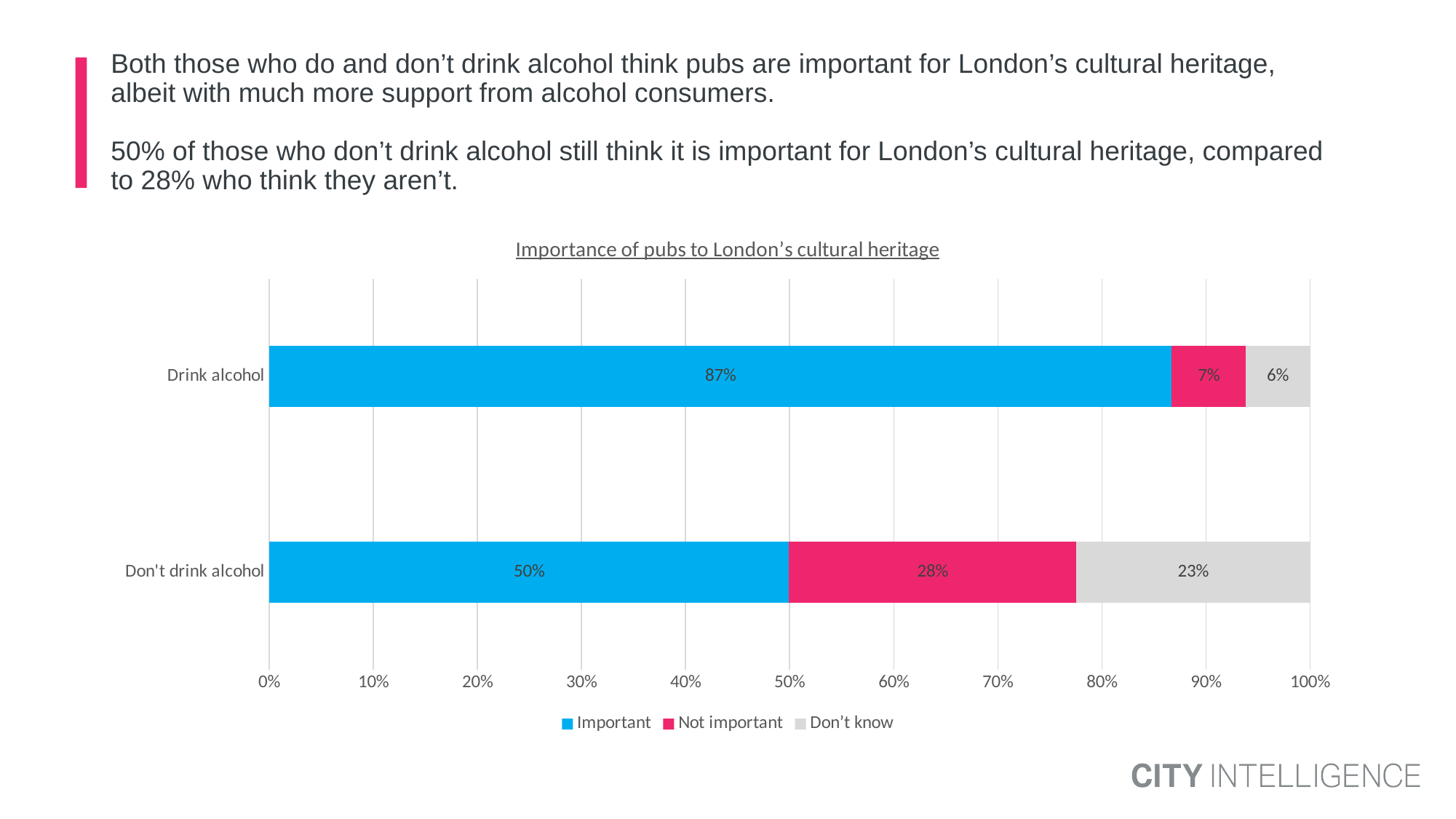
How many categories are shown on the chart? 2 Which category has the higher 'Important' value? Drink alcohol What percentage of those who drink alcohol say pubs are important to London's cultural heritage? 87% How many series does the legend list? 3 What kind of chart is shown on the slide? Stacked bar chart What is the title of the chart? Importance of pubs to London's cultural heritage What is the 'Don't know' value for the 'Don't drink alcohol' category? 23% Which category has the lower 'Don't know' value? Drink alcohol What percentage of those who don't drink alcohol say pubs are not important? 28% What is the difference between the 'Important' values for 'Drink alcohol' and 'Don't drink alcohol'? 37% Is the 'Not important' value larger for 'Drink alcohol' or 'Don't drink alcohol'? Don't drink alcohol What is the 'Not important' value for the 'Drink alcohol' category? 7%